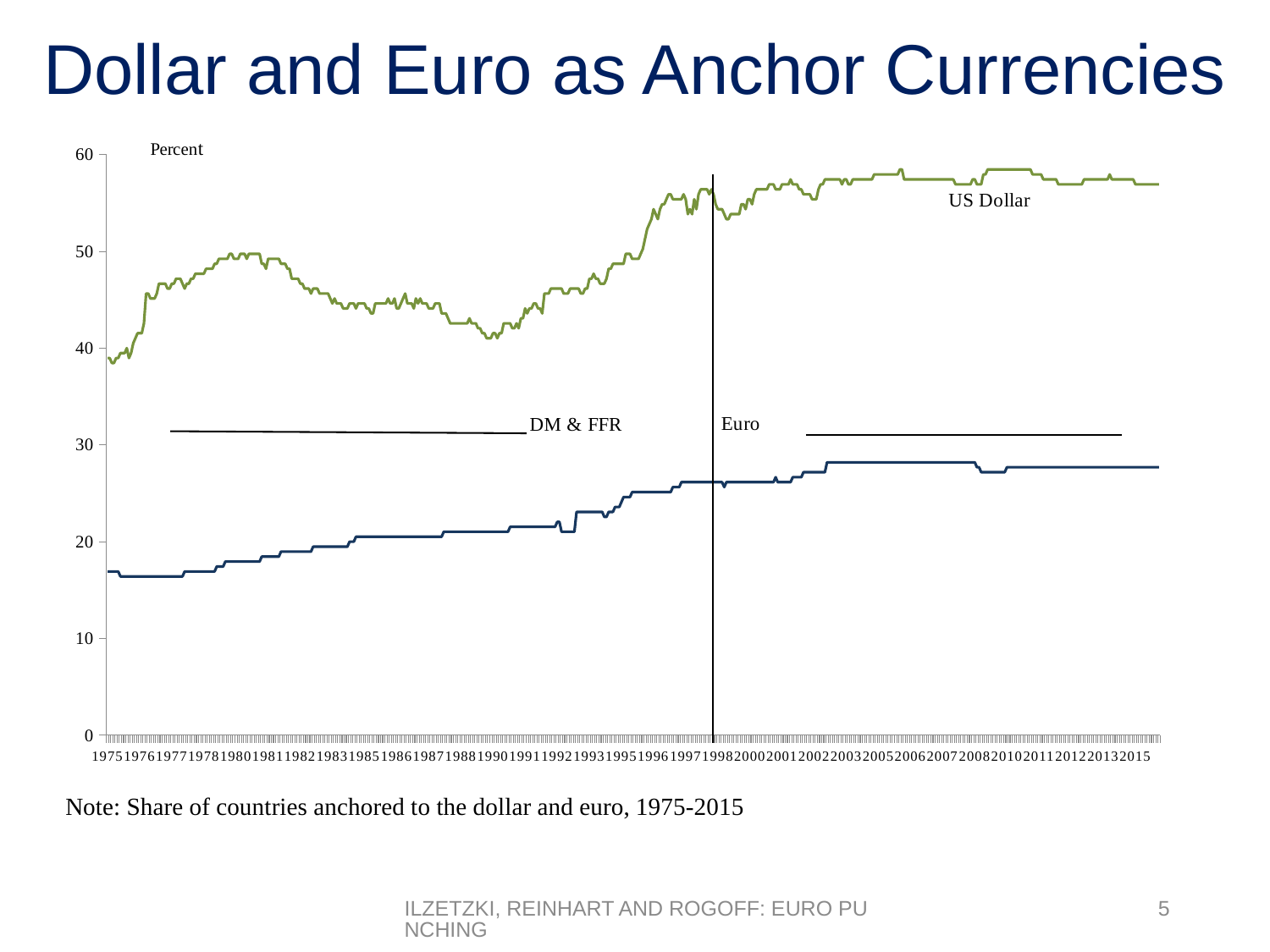
Is the value of the Euro line in 2015 greater or less than 30? less How many lines (series) are plotted on the chart? 2 In 2015, which line is higher: US Dollar or Euro? US Dollar What is the title of the slide's chart? Dollar and Euro as Anchor Currencies Does the DM & FFR / Euro line generally rise or fall from 1975 to 2015? Rise Is the value of the Euro line in 2015 greater or less than 20? greater Is the value of the US Dollar line in 2015 greater or less than 50? greater What kind of chart is shown on the slide? Line chart Is the US Dollar line higher in 2015 than in 1975? Yes What label is shown at the top of the vertical axis? Percent